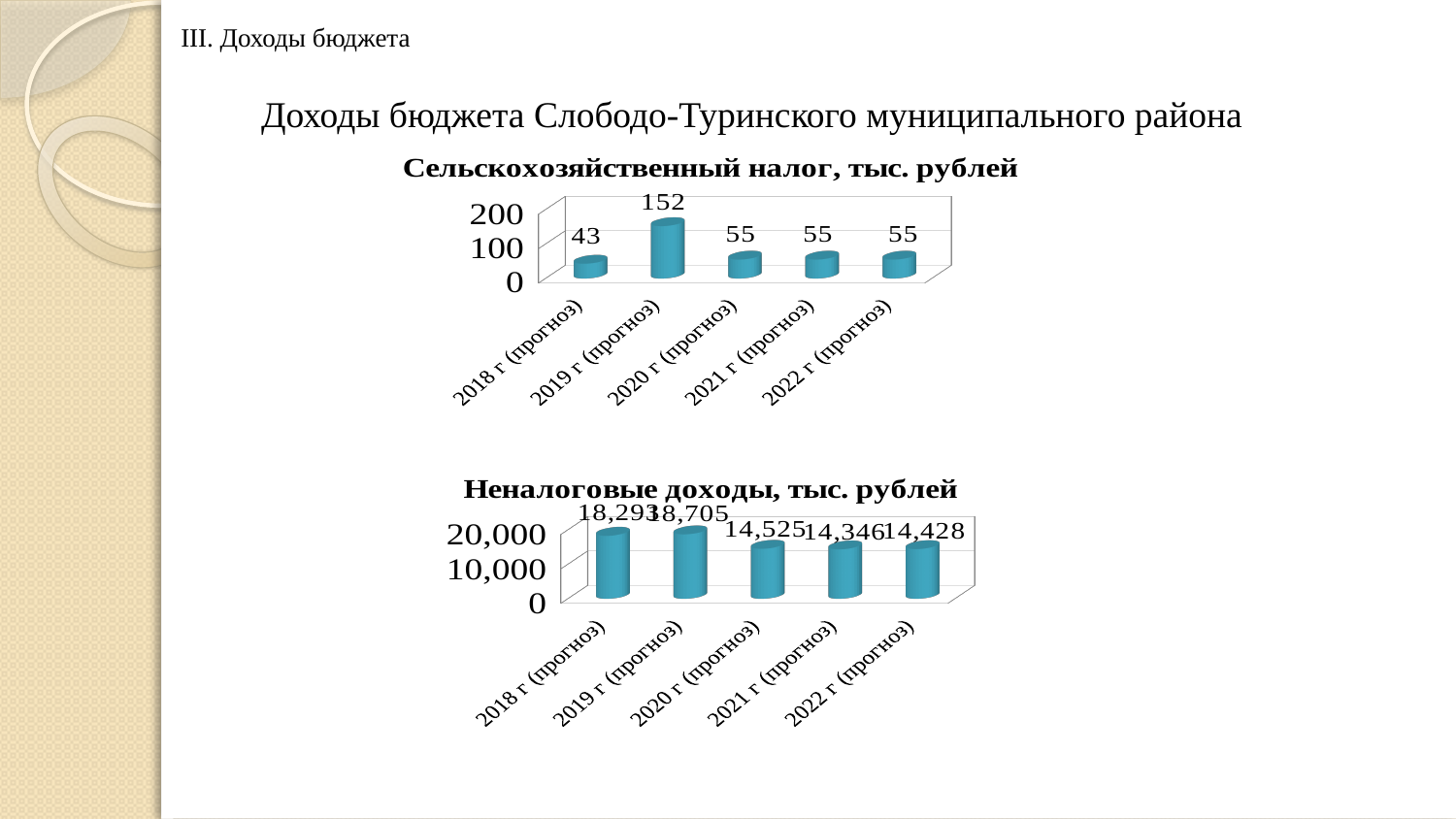
In the chart titled 'Неналоговые доходы, тыс. рублей', which year has the highest value? 2019 г (прогноз) In the chart titled 'Неналоговые доходы, тыс. рублей', what is the value for 2020 г (прогноз)? 14,525 What kind of chart is the bottom chart titled 'Неналоговые доходы, тыс. рублей'? bar chart In the chart titled 'Сельскохозяйственный налог, тыс. рублей', what is the difference between the values for 2019 г (прогноз) and 2020 г (прогноз)? 97 In the chart titled 'Сельскохозяйственный налог, тыс. рублей', what is the value for 2018 г (прогноз)? 43 In the chart titled 'Неналоговые доходы, тыс. рублей', is the value for 2019 г (прогноз) greater or less than 10,000? greater In the chart titled 'Неналоговые доходы, тыс. рублей', what is the value for 2022 г (прогноз)? 14,428 In the chart titled 'Сельскохозяйственный налог, тыс. рублей', which year has the highest value? 2019 г (прогноз) In the chart titled 'Неналоговые доходы, тыс. рублей', which year has the lowest value? 2021 г (прогноз) In the chart titled 'Сельскохозяйственный налог, тыс. рублей', which year has the lowest value? 2018 г (прогноз) In the chart titled 'Сельскохозяйственный налог, тыс. рублей', how many bars are plotted? 5 In the chart titled 'Сельскохозяйственный налог, тыс. рублей', what is the value for 2019 г (прогноз)? 152